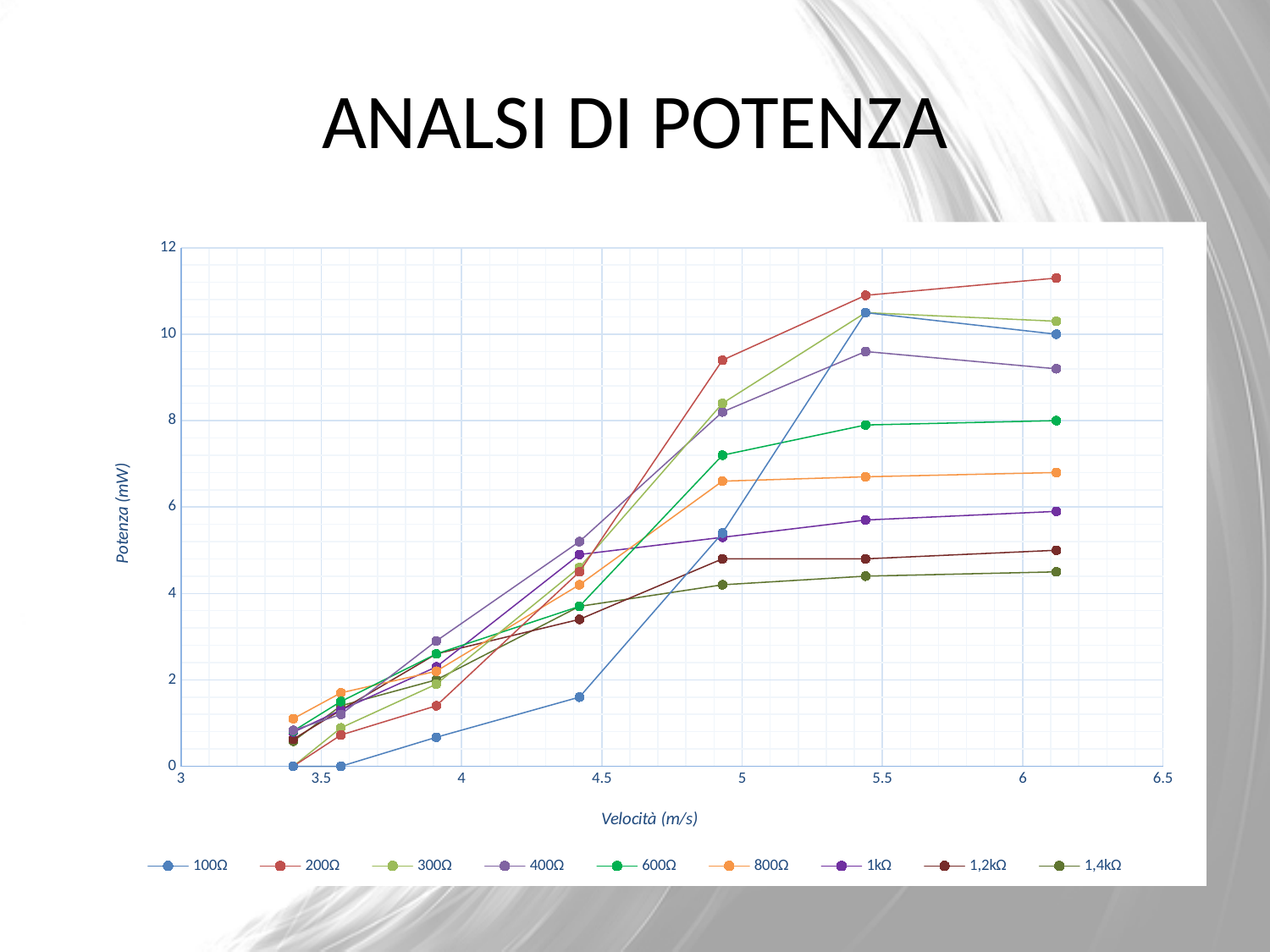
Is the value for 1,4kΩ at the highest velocity plotted greater or less than 6? less At the highest velocity plotted, which is larger: the value for 200Ω or the value for 1,4kΩ? 200Ω Which series has the lowest power value at the highest velocity plotted? 1,4kΩ What kind of chart is shown on the slide? line chart Which series reaches the highest power value on the chart? 200Ω What is the title of the chart on the slide? ANALSI DI POTENZA Does the power for the 200Ω series rise or fall as velocity increases? rise What is the label of the vertical axis? Potenza (mW) Is the value for 200Ω at the highest velocity plotted greater or less than 10? greater How many data points are plotted for the 100Ω series? 7 How many series does the legend list? 9 Is the value for 800Ω at the highest velocity plotted greater or less than 6? greater